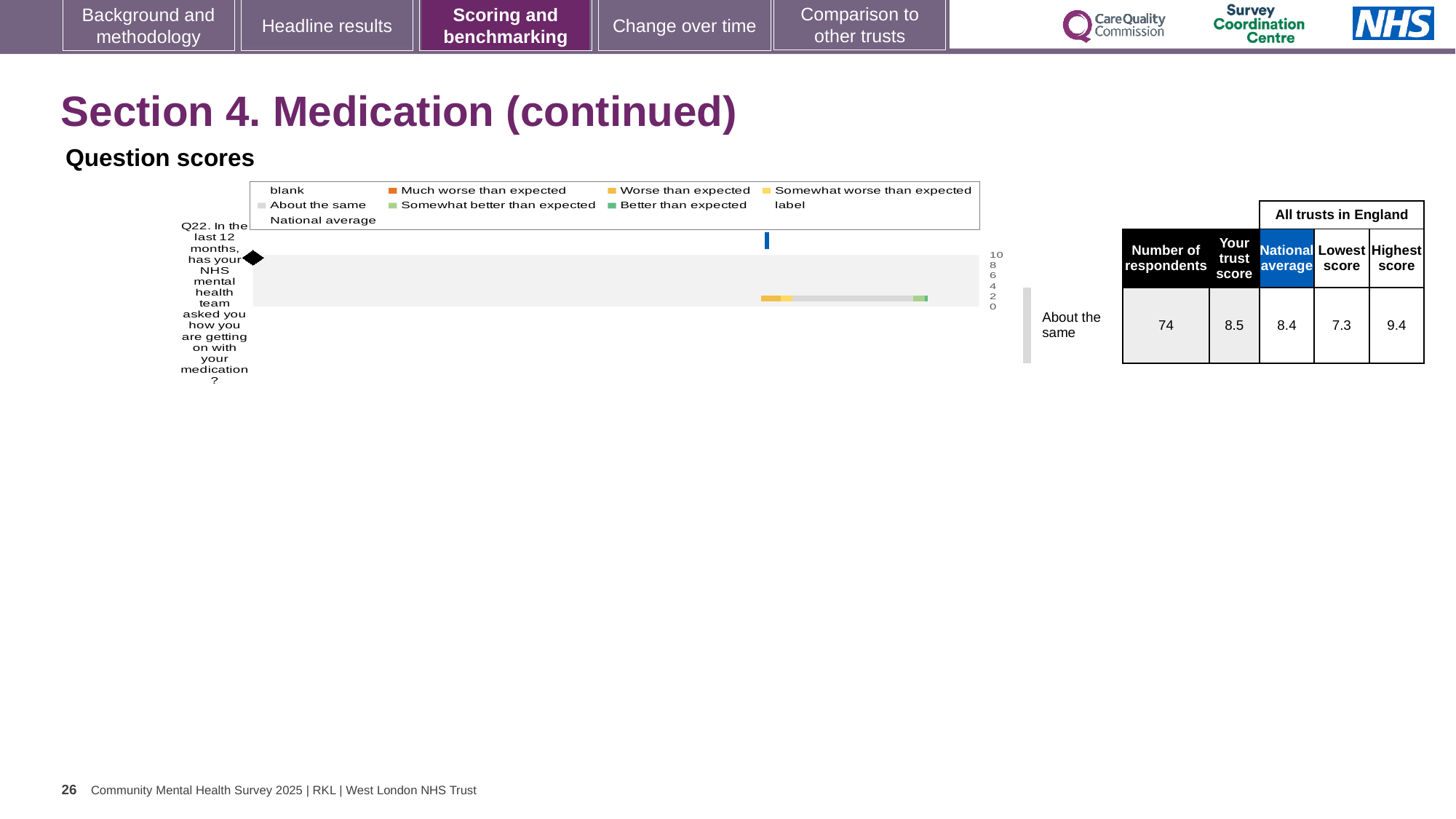
What is the highest score among all trusts in England for Q22? 9.4 Is the trust score for Q22 greater or less than 8? greater What benchmark category is the trust's Q22 score placed in? About the same Which question is plotted in the Question scores chart? Q22. In the last 12 months, has your NHS mental health team asked you how you are getting on with your medication? How many respondents answered Q22? 74 Which is larger for Q22, the trust score or the national average? trust score What is the trust's score for Q22? 8.5 What is the lowest score among all trusts in England for Q22? 7.3 What is the difference between the highest score and the lowest score for Q22? 2.1 What is the national average score for Q22? 8.4 How many questions (categories) are plotted in the Question scores chart? 1 What kind of chart is shown under 'Question scores'? bar chart